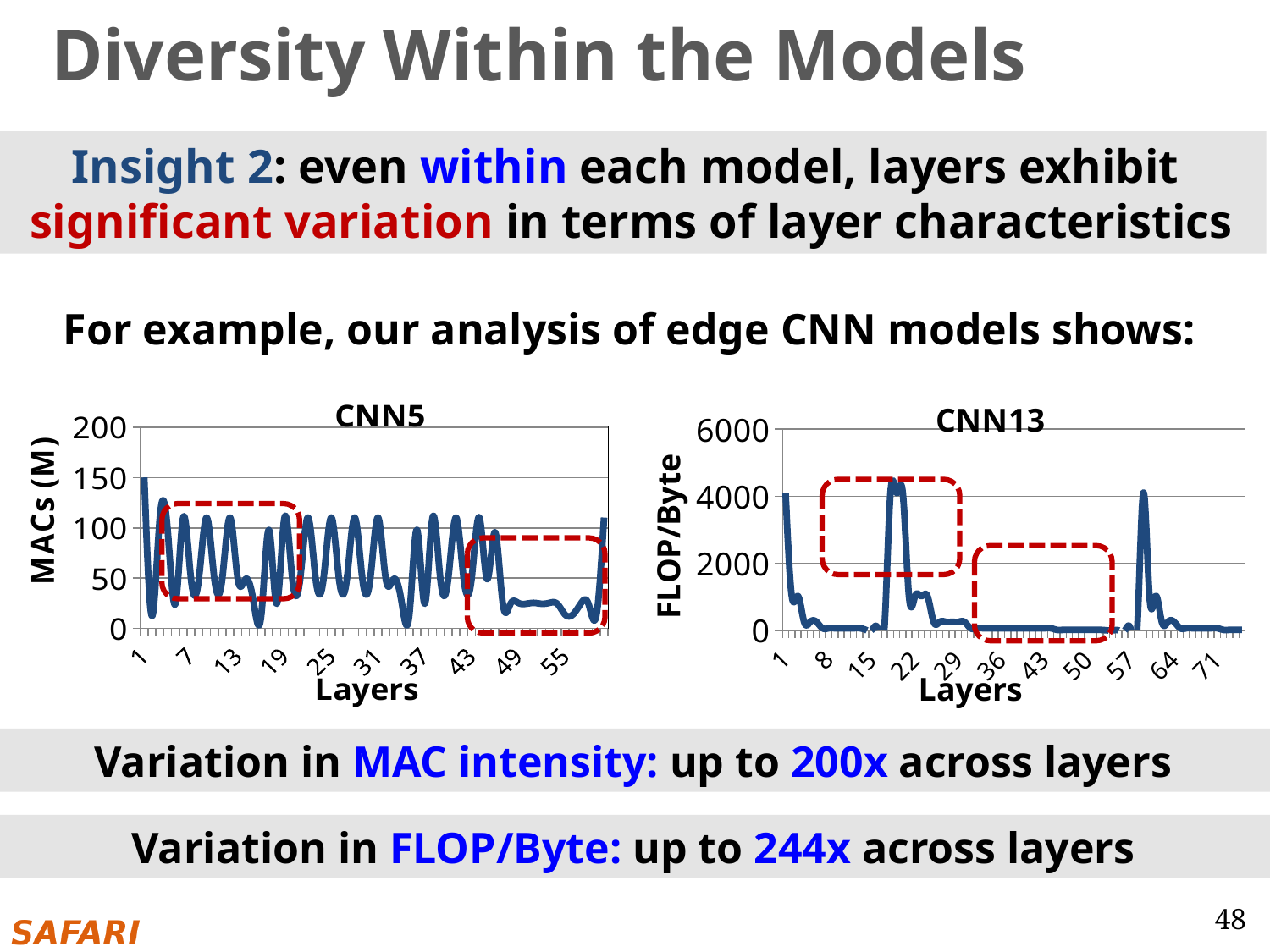
What kind of chart is the CNN5 chart? line chart In the CNN5 chart, is the value at layer 1 larger than the value at layer 49? yes What is the y-axis label of the CNN5 chart? MACs (M) What is the y-axis label of the CNN13 chart? FLOP/Byte In the CNN13 chart, what is the highest value shown on the y-axis? 6000 In the CNN13 chart, is the value at layer 43 greater or less than 2000? less How many charts are shown on the slide? 2 In the CNN5 chart, is the value at layer 1 greater or less than 100? greater In the CNN5 chart, which layer has the highest MACs value? 1 In the CNN5 chart, is the value at layer 49 greater or less than 50? less What kind of chart is the CNN13 chart? line chart